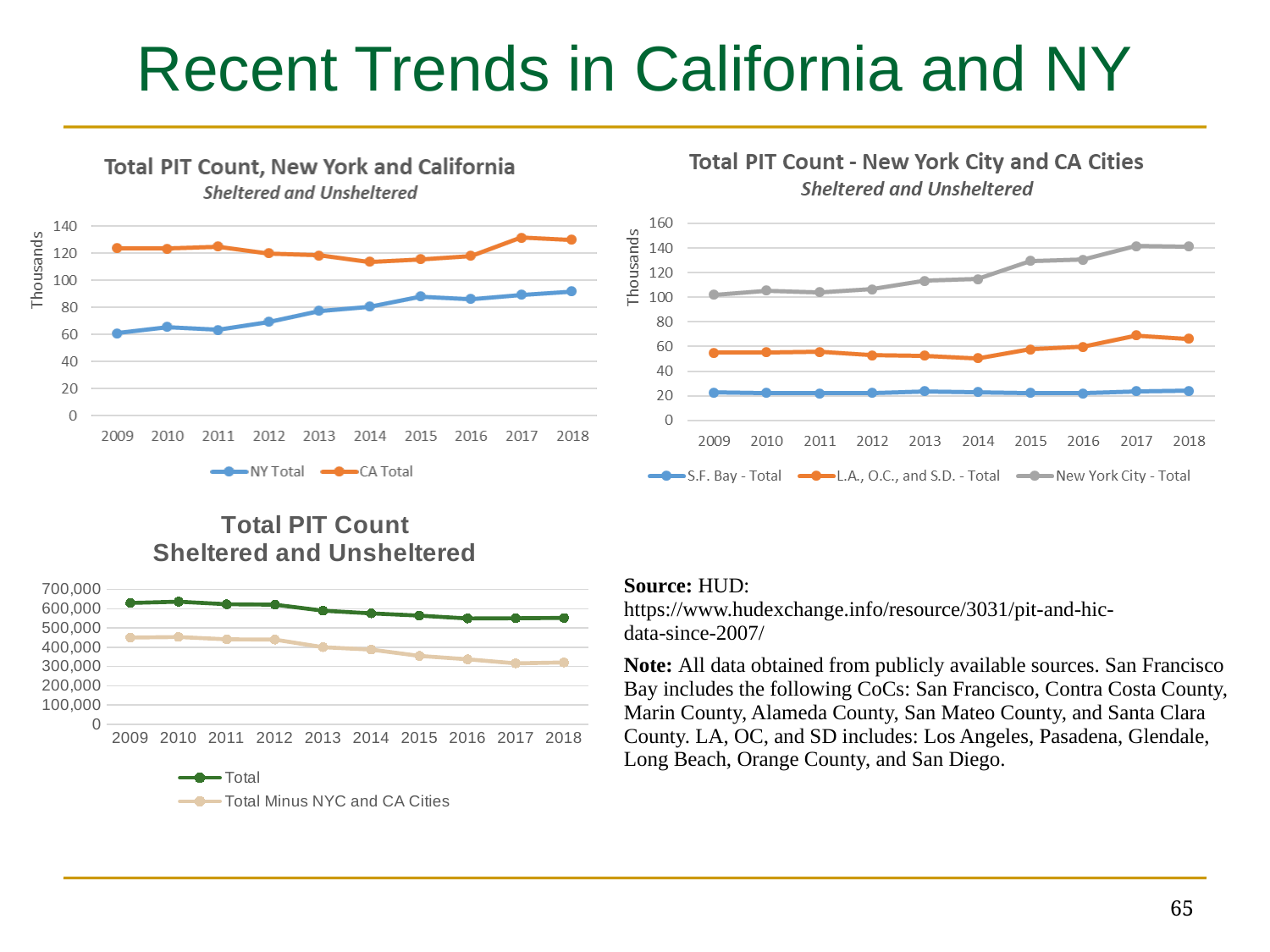
In the 'Total PIT Count, New York and California' chart, which series is higher in 2018, NY Total or CA Total? CA Total In the 'Total PIT Count, New York and California' chart, is the NY Total for 2018 greater or less than 100? less In the 'Total PIT Count - New York City and CA Cities' chart, is the New York City - Total for 2018 greater or less than 120? greater In the 'Total PIT Count - New York City and CA Cities' chart, which series has the highest values across all years? New York City - Total What is the y-axis label of the 'Total PIT Count, New York and California' chart? Thousands What kind of chart is the 'Total PIT Count, New York and California' chart? line chart How many series does the legend list in the 'Total PIT Count - New York City and CA Cities' chart? 3 In the 'Total PIT Count Sheltered and Unsheltered' chart (bottom left), is the Total Minus NYC and CA Cities value for 2018 greater or less than 400,000? less In the 'Total PIT Count Sheltered and Unsheltered' chart (bottom left), does the Total series rise or fall from 2009 to 2018? fall How many years are shown on the x axis of the 'Total PIT Count, New York and California' chart? 10 In the 'Total PIT Count, New York and California' chart, does the NY Total rise or fall from 2009 to 2018? rise In the 'Total PIT Count - New York City and CA Cities' chart, which series has the lowest values across all years? S.F. Bay - Total